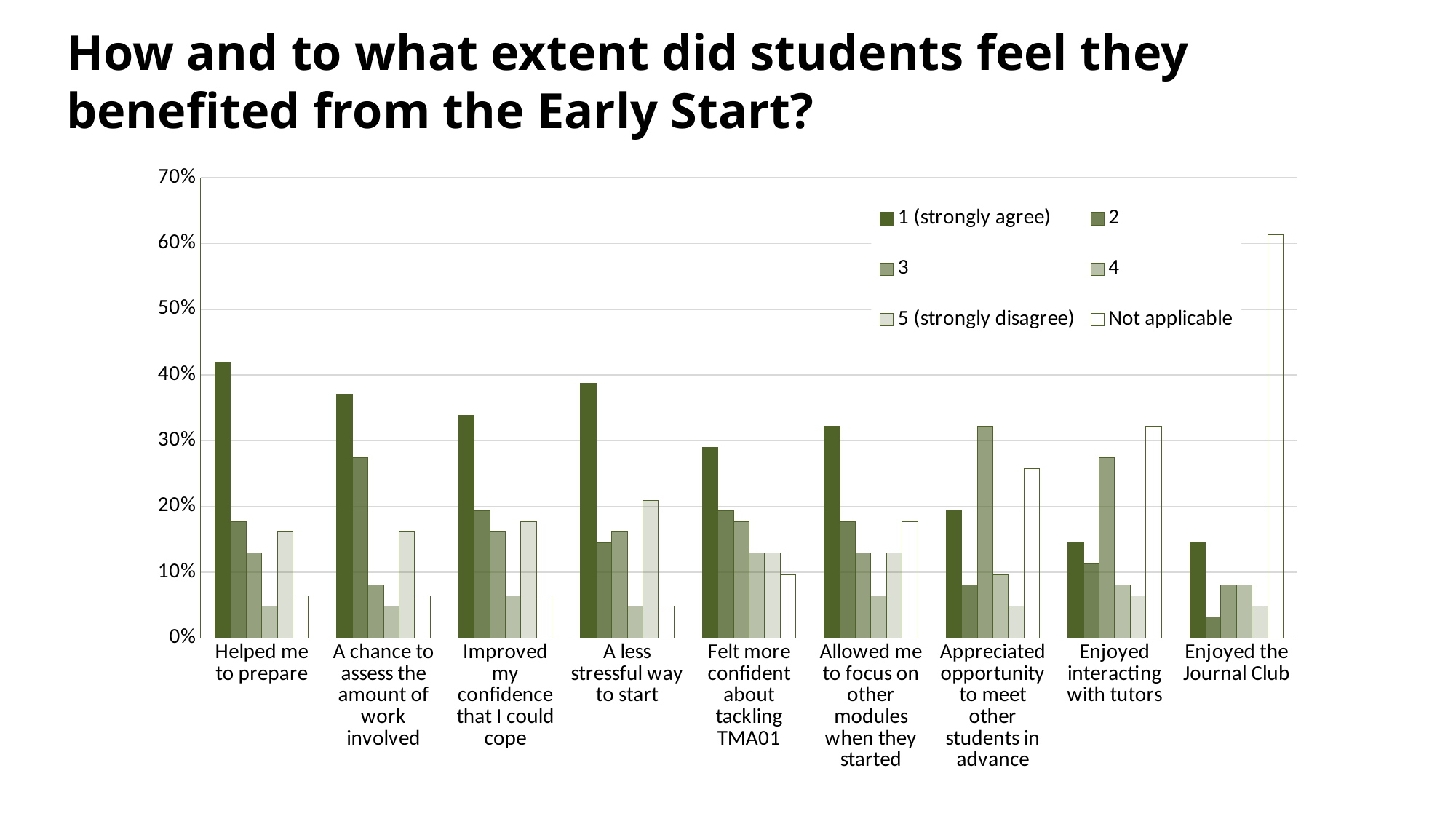
Which has the larger 'Not applicable' value: 'Enjoyed interacting with tutors' or 'Appreciated opportunity to meet other students in advance'? Enjoyed interacting with tutors Which category has the highest 'Not applicable' value? Enjoyed the Journal Club Which category has the lowest value for the '2' series? Enjoyed the Journal Club Is the '3' value for 'Appreciated opportunity to meet other students in advance' greater or less than 30%? greater How many statement categories are shown along the x axis? 9 What is the legend label for the darkest green series? 1 (strongly agree) Is the 'Not applicable' value for 'Enjoyed the Journal Club' greater or less than 50%? greater Is the '1 (strongly agree)' value for 'Helped me to prepare' greater or less than 40%? greater Which category has the highest value for the '1 (strongly agree)' series? Helped me to prepare How many series does the legend list? 6 What kind of chart is shown on the slide? bar chart Which has the larger '1 (strongly agree)' value: 'Helped me to prepare' or 'Felt more confident about tackling TMA01'? Helped me to prepare